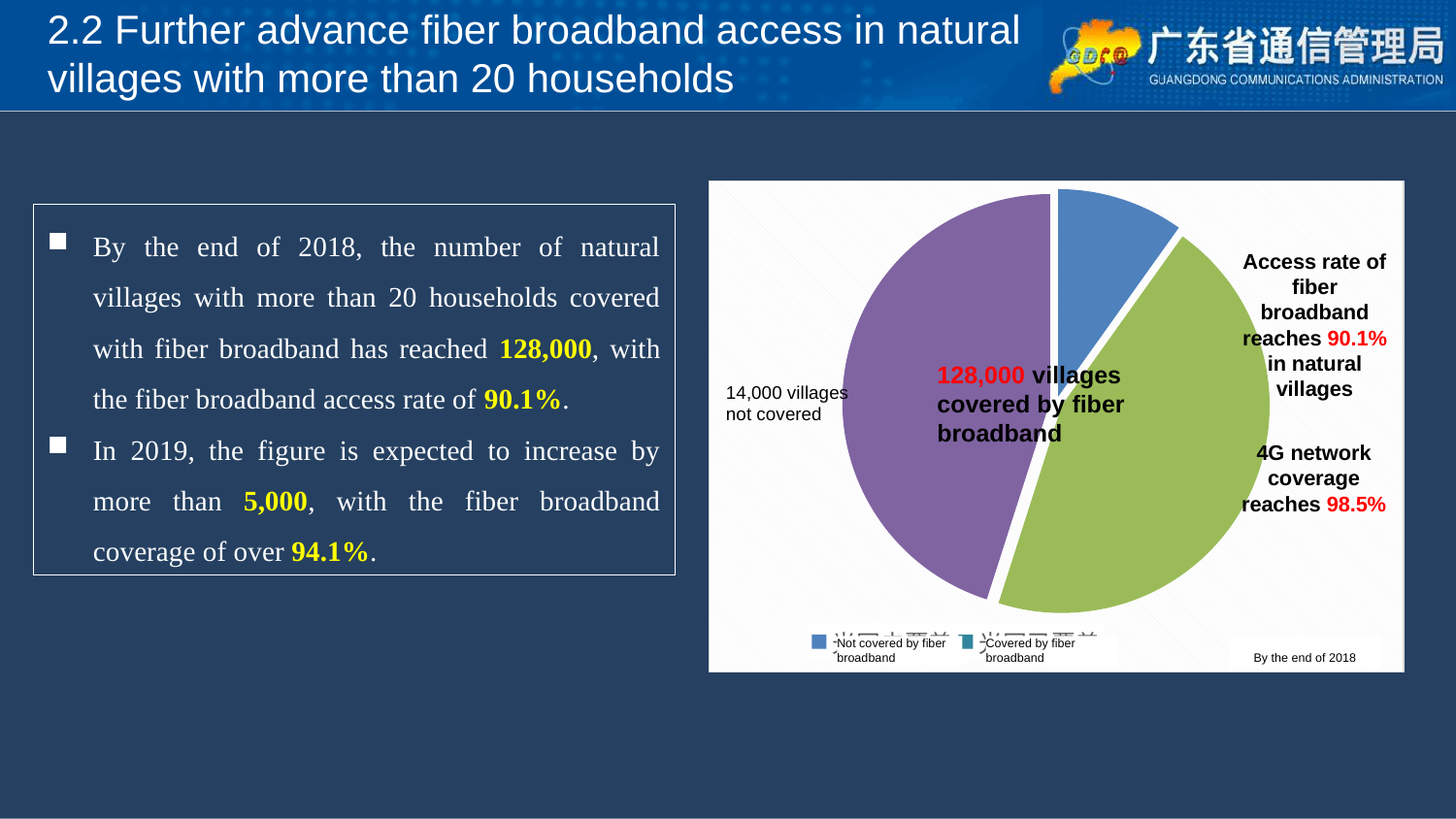
Which is larger: the number of villages covered by fiber broadband or the number not covered? covered by fiber broadband What time reference is printed in the bottom right corner of the chart? By the end of 2018 What fiber broadband access rate in natural villages does the chart state? 90.1% What are the two legend entries of the chart? Not covered by fiber broadband; Covered by fiber broadband How many entries does the chart legend list? 2 What is the difference between the number of villages covered by fiber broadband (128,000) and the number not covered (14,000)? 114,000 What 4G network coverage rate does the chart state? 98.5% How many slices does the pie chart have? 3 According to the chart, how many villages are covered by fiber broadband? 128,000 villages What kind of chart is shown on the slide? pie chart What is the total of the 128,000 covered villages and the 14,000 not covered villages? 142,000 According to the chart, how many villages are not covered by fiber broadband? 14,000 villages